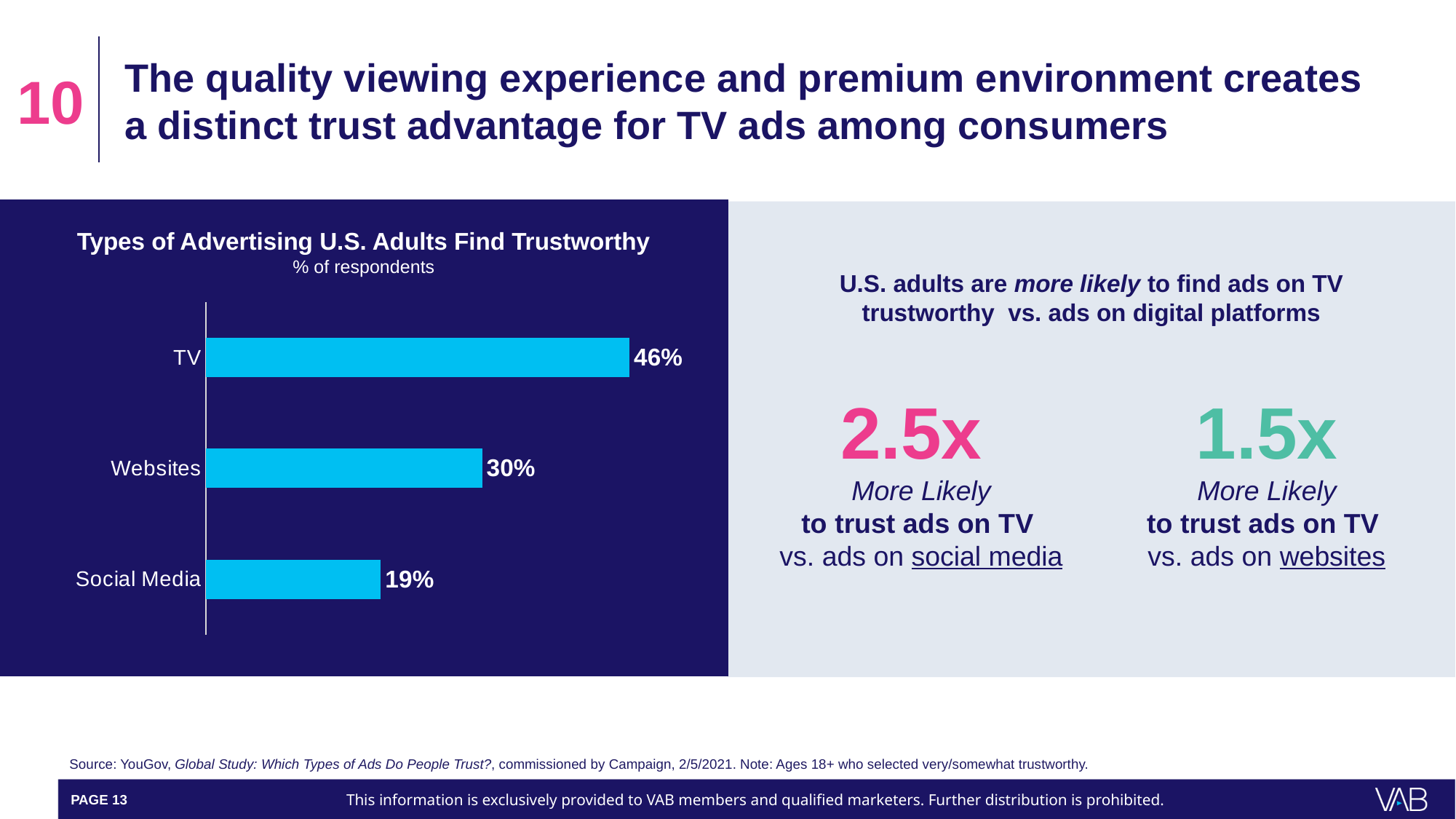
What kind of chart is used to show the types of advertising U.S. adults find trustworthy? Bar chart Which has a higher value, Websites or Social Media? Websites What is the title of the chart? Types of Advertising U.S. Adults Find Trustworthy Which type of advertising has the highest share of respondents finding it trustworthy? TV What percentage of respondents find advertising on websites trustworthy? 30% What is the difference in percentage points between TV and Social Media? 27 percentage points What percentage of respondents find social media advertising trustworthy? 19% What percentage of respondents find TV advertising trustworthy? 46% What unit is the chart measured in, according to its subtitle? % of respondents What is the difference in percentage points between TV and Websites? 16 percentage points Which type of advertising has the lowest share of respondents finding it trustworthy? Social Media How many types of advertising are shown in the chart? 3